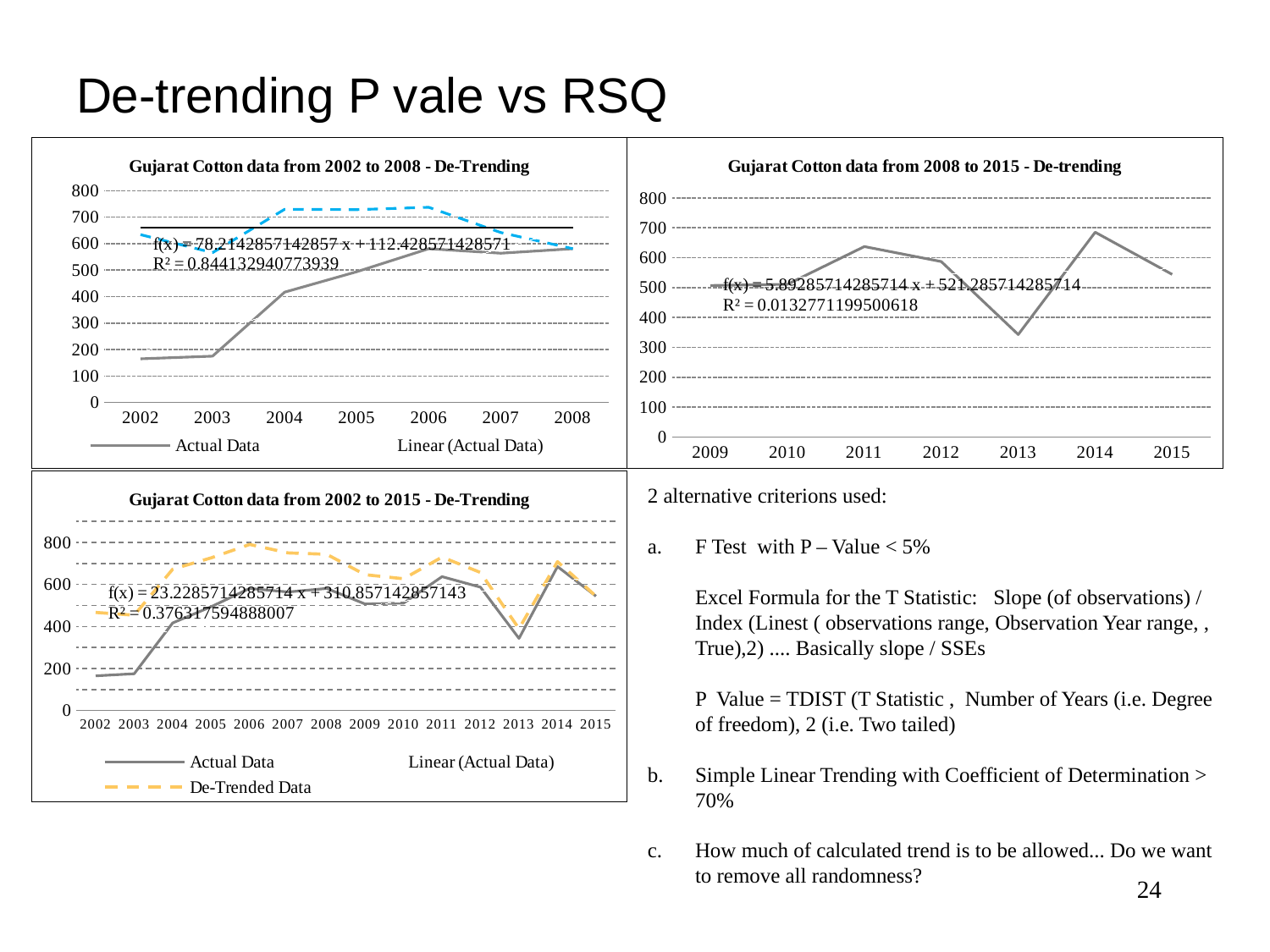
How many years are shown on the x axis of the 'Gujarat Cotton data from 2002 to 2008 - De-Trending' chart? 7 In the 'Gujarat Cotton data from 2008 to 2015 - De-trending' chart, is the value for 2013 greater or less than 400? less In the 'Gujarat Cotton data from 2002 to 2008 - De-Trending' chart, is the Actual Data value for 2006 greater or less than 500? greater In the 'Gujarat Cotton data from 2008 to 2015 - De-trending' chart, which year has the highest value? 2014 What kind of chart is the 'Gujarat Cotton data from 2002 to 2008 - De-Trending' chart? Line chart In the 'Gujarat Cotton data from 2002 to 2015 - De-Trending' chart, is the Actual Data value for 2014 larger or smaller than the value for 2013? Larger What R² value is printed on the 'Gujarat Cotton data from 2002 to 2008 - De-Trending' chart? 0.844132940773939 In the 'Gujarat Cotton data from 2002 to 2008 - De-Trending' chart, does the Actual Data line generally rise or fall from 2002 to 2008? Rise In the 'Gujarat Cotton data from 2008 to 2015 - De-trending' chart, which year has the lowest value? 2013 In the 'Gujarat Cotton data from 2002 to 2008 - De-Trending' chart, is the Actual Data value for 2002 greater or less than 200? less How many series does the legend of the 'Gujarat Cotton data from 2002 to 2015 - De-Trending' chart list? 3 How many years are shown on the x axis of the 'Gujarat Cotton data from 2002 to 2015 - De-Trending' chart? 14